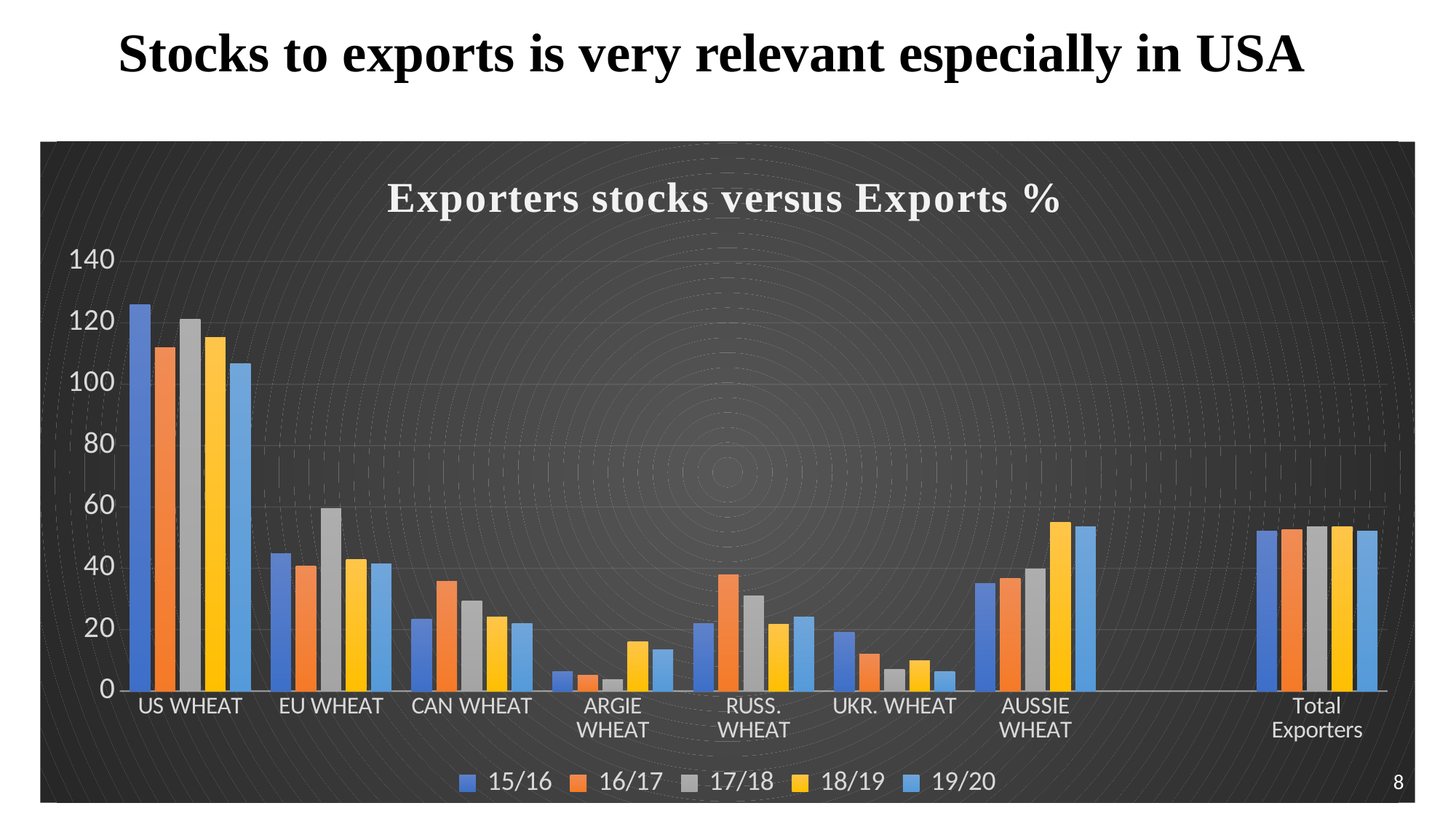
How many categories are shown on the x axis? 8 How many series does the legend list? 5 What is the title of the chart? Exporters stocks versus Exports % Which colour represents the 18/19 series in the legend? yellow Is the 17/18 value for EU WHEAT greater or less than 40? greater Which category has the highest 15/16 value? US WHEAT Is the 15/16 value for US WHEAT greater or less than 120? greater Which is larger, the 18/19 value for AUSSIE WHEAT or the 18/19 value for EU WHEAT? AUSSIE WHEAT For US WHEAT, which season has the highest value? 15/16 Which category has the lowest 16/17 value? ARGIE WHEAT What kind of chart is shown on the slide? bar chart Is the 18/19 value for ARGIE WHEAT greater or less than 20? less